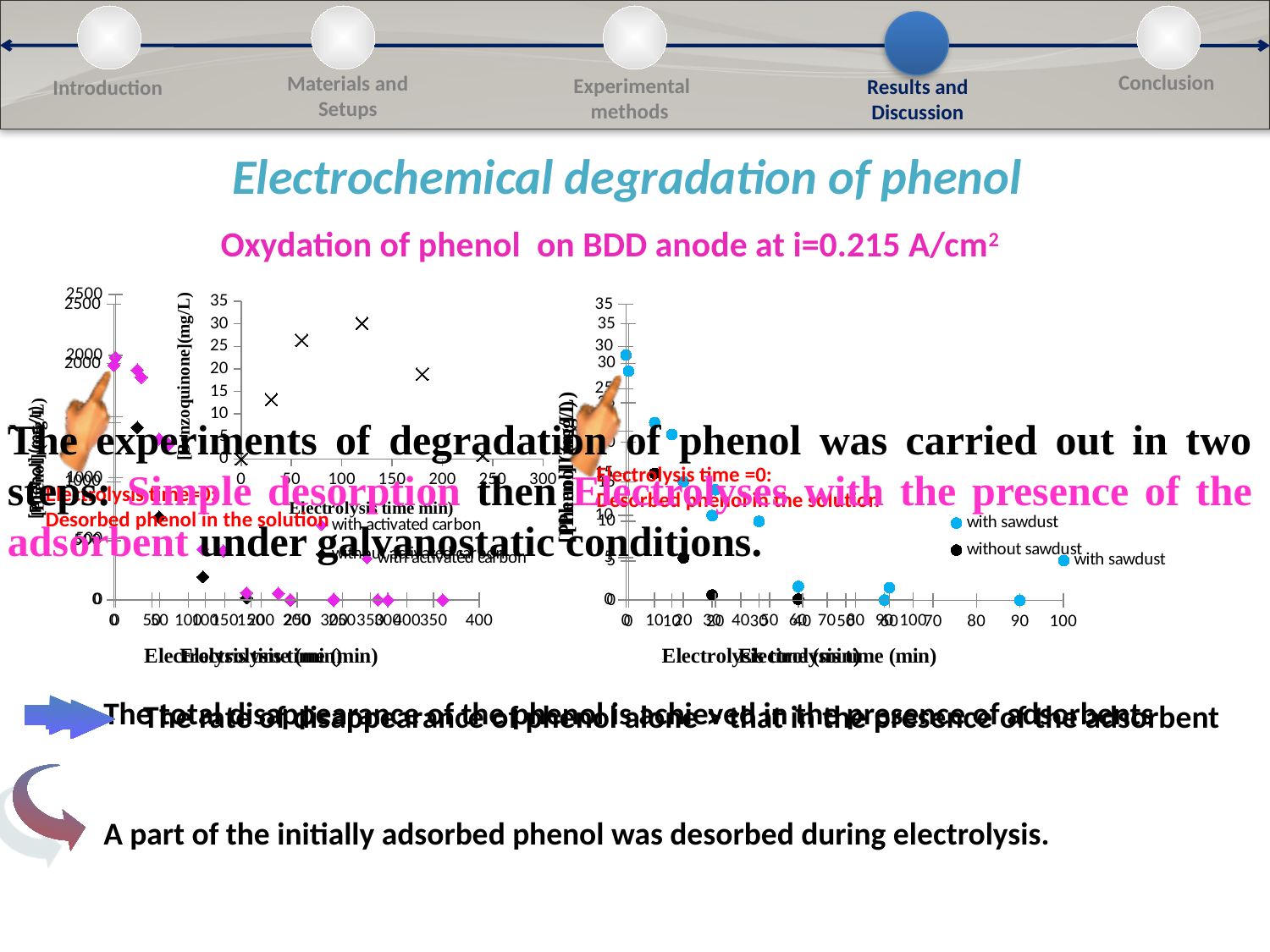
What are the two legend entries of the right-hand chart? with sawdust, without sawdust What kind of chart is shown on the right side of the slide? scatter chart In the right-hand chart, do the values of the 'with sawdust' series rise or fall as electrolysis time increases? fall What kind of chart is shown on the left side of the slide? scatter chart What is the x-axis title of the right-hand chart? Electrolysis time (min)